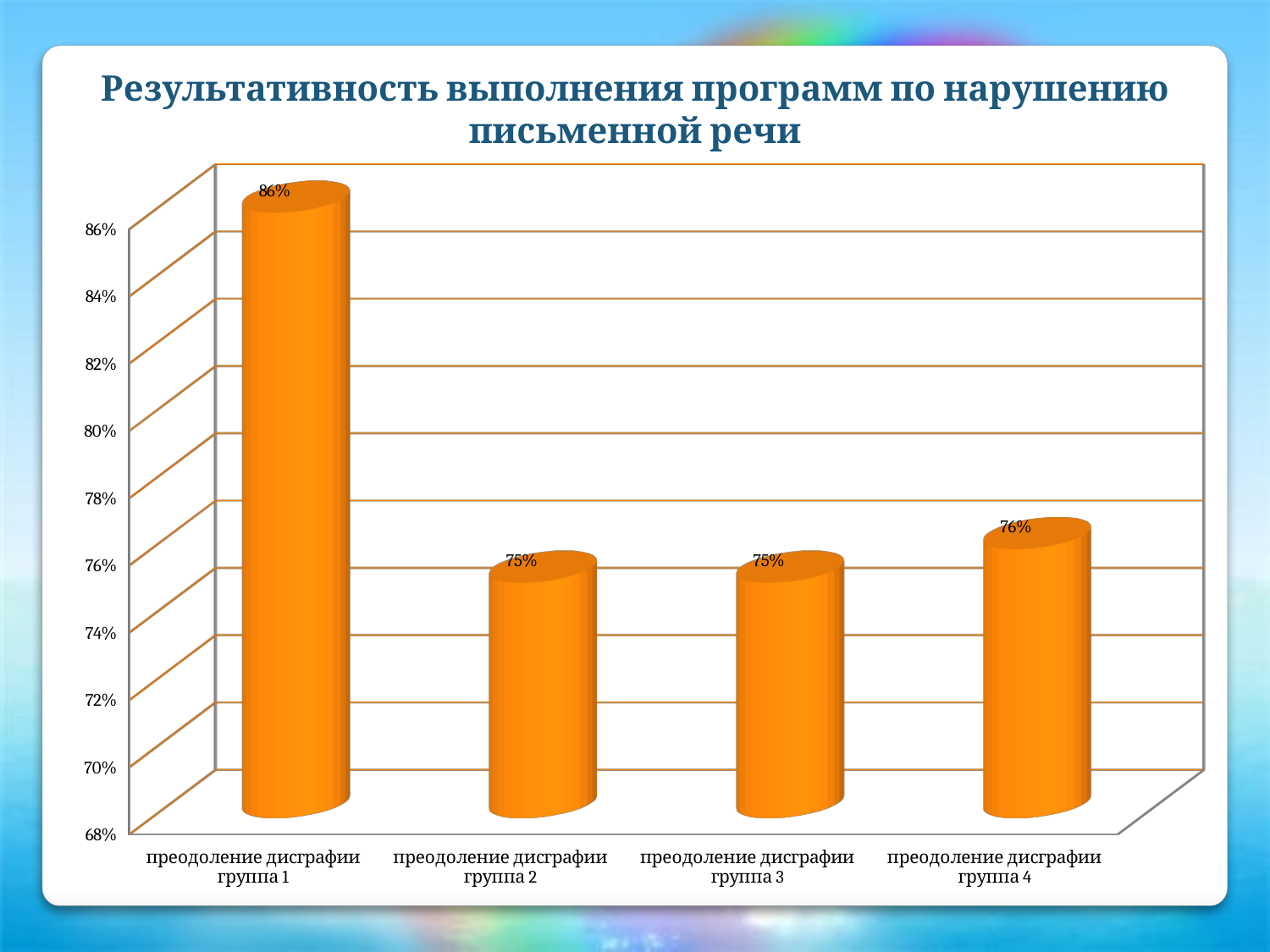
How many categories are shown on the chart? 4 What colour are the bars in the chart? orange What is the title of the chart? Результативность выполнения программ по нарушению письменной речи Which is larger, the value for группа 1 or the value for группа 2? группа 1 What kind of chart is shown on the slide? bar chart Is the value for преодоление дисграфии группа 3 greater or less than 80%? less What is the value for преодоление дисграфии группа 2? 75% What is the value for преодоление дисграфии группа 1? 86% What is the difference between the values for группа 1 and группа 4? 10% What is the value for преодоление дисграфии группа 4? 76% What is the difference between the values for группа 4 and группа 3? 1% Which category has the highest value? преодоление дисграфии группа 1